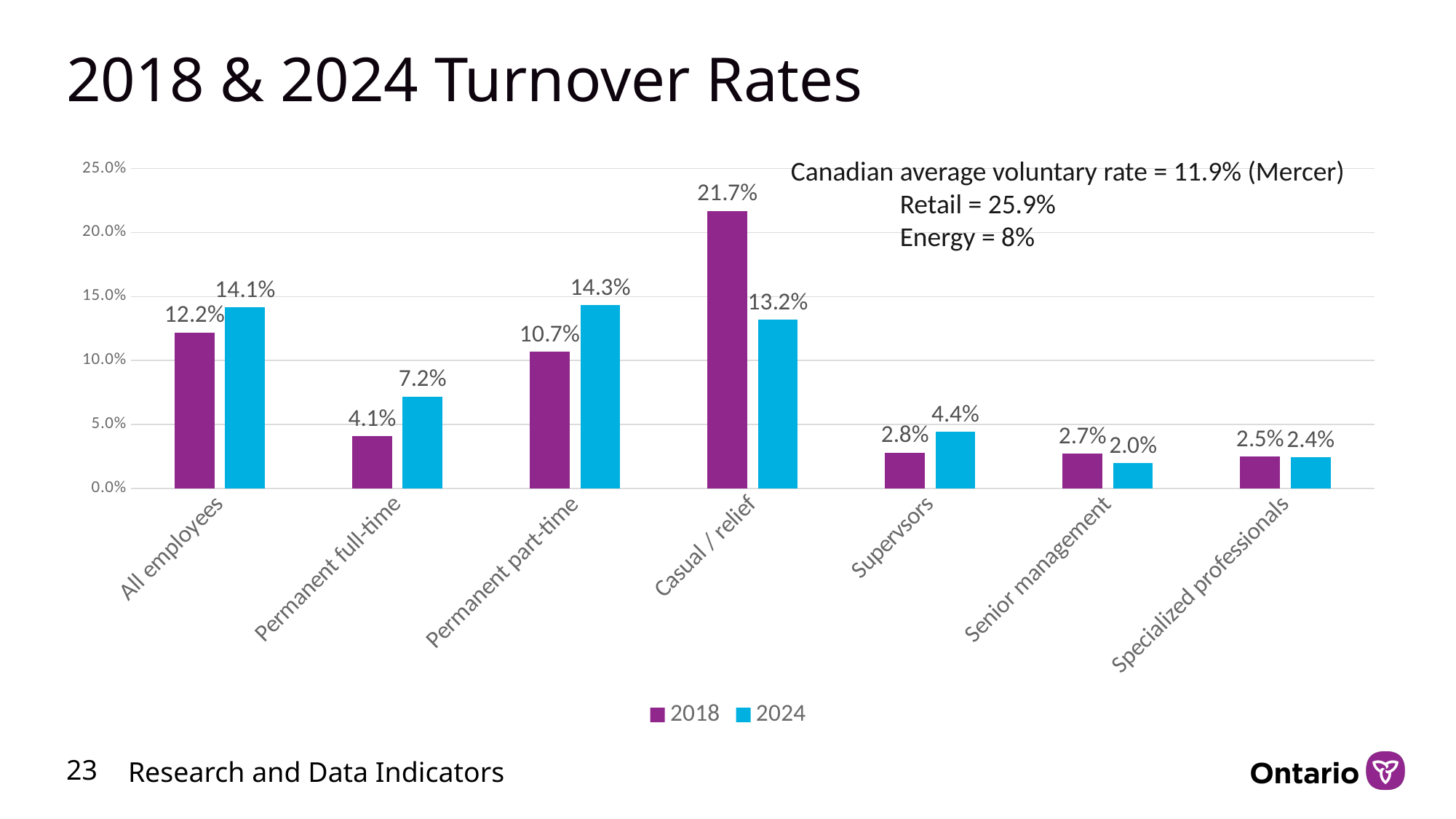
Is the 2024 turnover rate for Permanent part-time employees greater or less than 10.0%? greater What was the 2024 turnover rate for All employees? 14.1% Which is larger for Supervisors: the 2018 rate or the 2024 rate? 2024 Which category had the lowest 2024 turnover rate? Senior management How many employee categories are shown on the x axis? 7 Which category had the highest 2018 turnover rate? Casual / relief How many series does the legend list? 2 What was the 2018 turnover rate for Casual / relief employees? 21.7% What is the difference between the 2018 and 2024 turnover rates for Casual / relief employees? 8.5% Which colour represents the 2024 series in the chart? Blue What was the 2024 turnover rate for Permanent full-time employees? 7.2% What kind of chart is shown on the slide? Bar chart